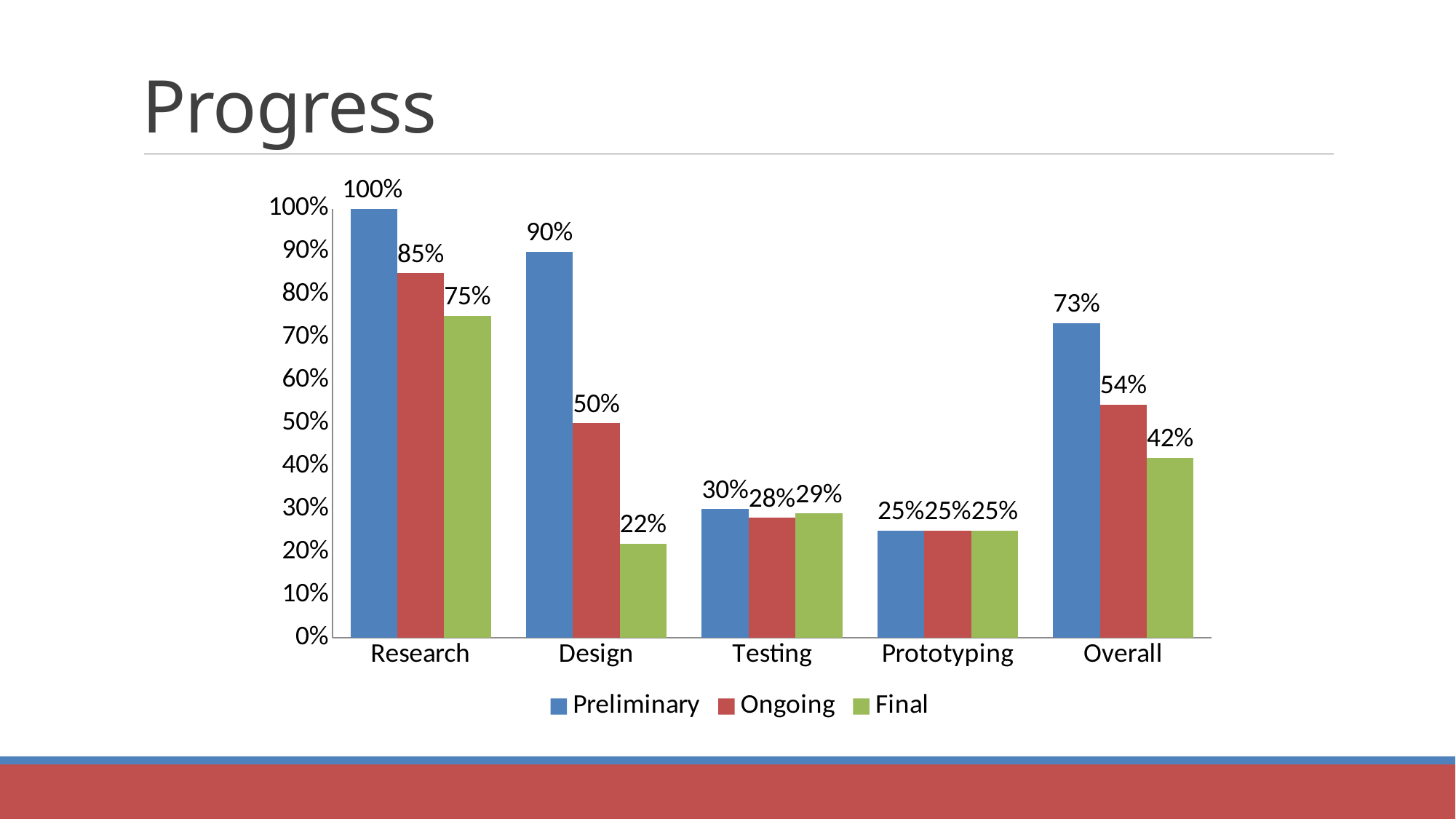
What is the Final value for Design? 22% What is the Preliminary value for Research? 100% How many categories are shown on the x axis? 5 Which category has the highest Final value? Research Which series is shown in green in the legend? Final How many series does the legend list? 3 Which is larger for Overall, the Preliminary value or the Final value? Preliminary Which category has the lowest Preliminary value? Prototyping Is the Ongoing value for Research greater or less than 80%? greater What is the difference between the Preliminary and Ongoing values for Design? 40% What kind of chart is shown on the slide? Bar chart What is the Ongoing value for Overall? 54%